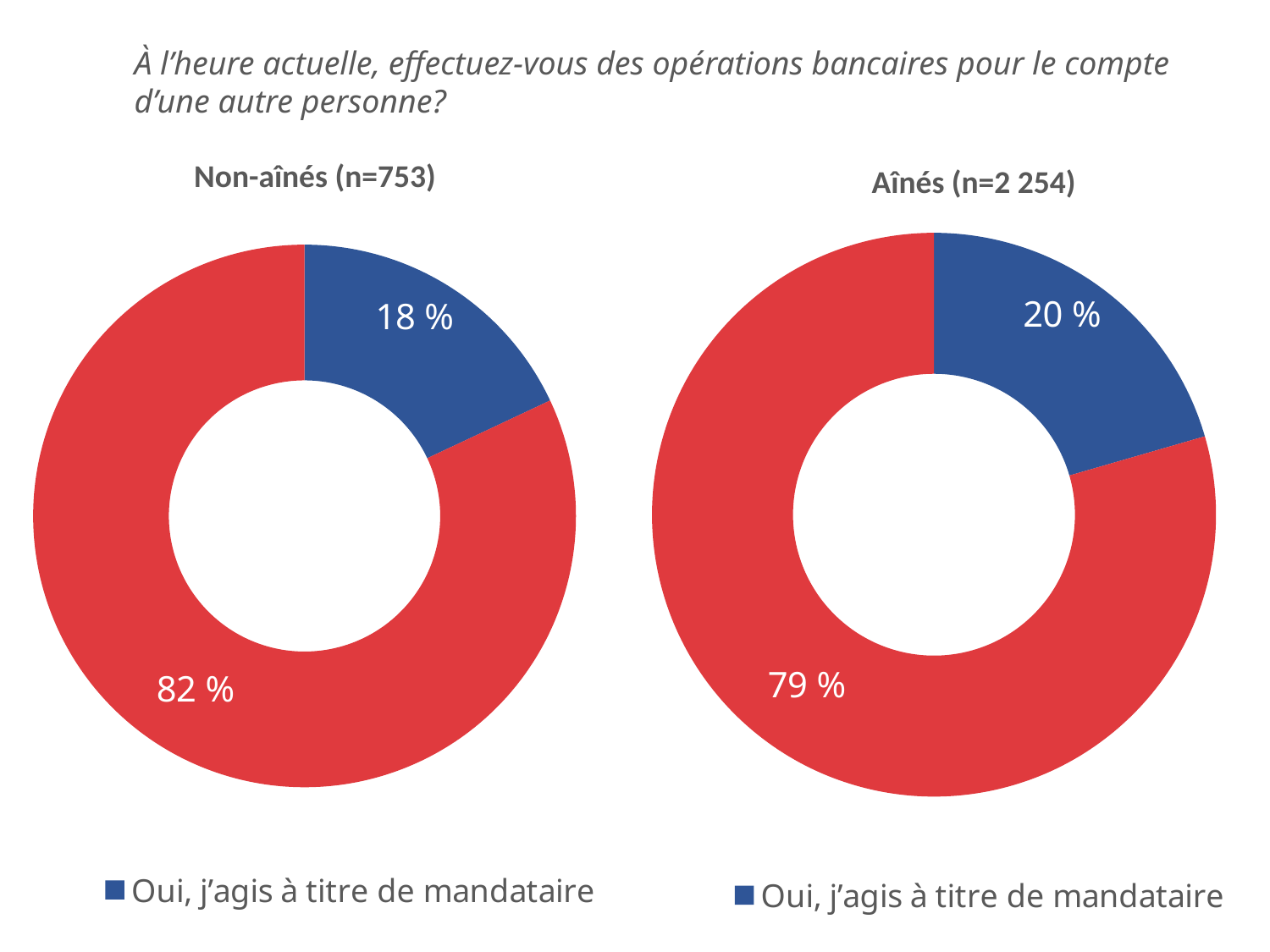
How many slices does the Aînés (n=2 254) chart have? 2 In the Aînés (n=2 254) chart, what percentage is shown for "Oui, j'agis à titre de mandataire"? 20 % Which chart shows the larger share for "Oui, j'agis à titre de mandataire", Non-aînés (n=753) or Aînés (n=2 254)? Aînés (n=2 254) How many entries does the legend under the Non-aînés (n=753) chart list? 1 In the Aînés (n=2 254) chart, what value is printed on the red slice? 79 % In the Aînés (n=2 254) chart, which slice is the largest? The red slice (79 %) In the Non-aînés (n=753) chart, what is the difference in percentage points between the red slice and the blue slice? 64 percentage points What type of chart is used on this slide? Donut (pie) chart In the Non-aînés (n=753) chart, what value is printed on the red slice? 82 % In the Non-aînés (n=753) chart, which slice is the smallest? Oui, j'agis à titre de mandataire (18 %) In the Non-aînés (n=753) chart, what percentage is shown for "Oui, j'agis à titre de mandataire"? 18 % What is the difference in percentage points between the "Oui, j'agis à titre de mandataire" share in the Aînés (n=2 254) chart and in the Non-aînés (n=753) chart? 2 percentage points